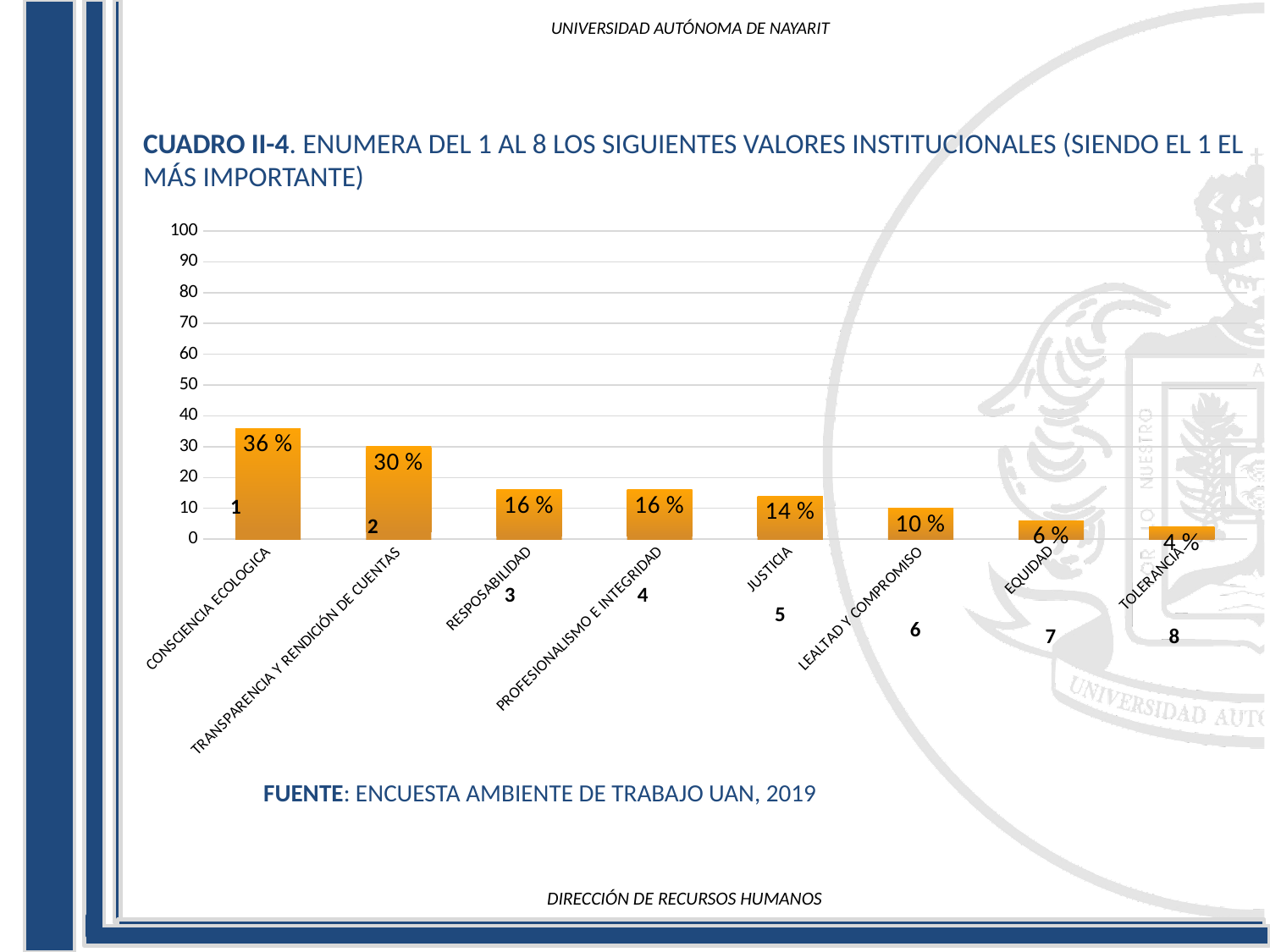
Do the values rise or fall from left to right along the x axis? fall What kind of chart is shown on the slide? bar chart Which category has the highest value? CONSCIENCIA ECOLOGICA Is the value for CONSCIENCIA ECOLOGICA greater or less than 30? greater What is the value for TRANSPARENCIA Y RENDICIÓN DE CUENTAS? 30 % How many categories are shown on the x axis? 8 What is the value for CONSCIENCIA ECOLOGICA? 36 % Which is larger, the value for LEALTAD Y COMPROMISO or the value for EQUIDAD? LEALTAD Y COMPROMISO What is the difference between the values for CONSCIENCIA ECOLOGICA and TRANSPARENCIA Y RENDICIÓN DE CUENTAS? 6 % What is the value for TOLERANCIA? 4 % Which category has the lowest value? TOLERANCIA What is the value for JUSTICIA? 14 %